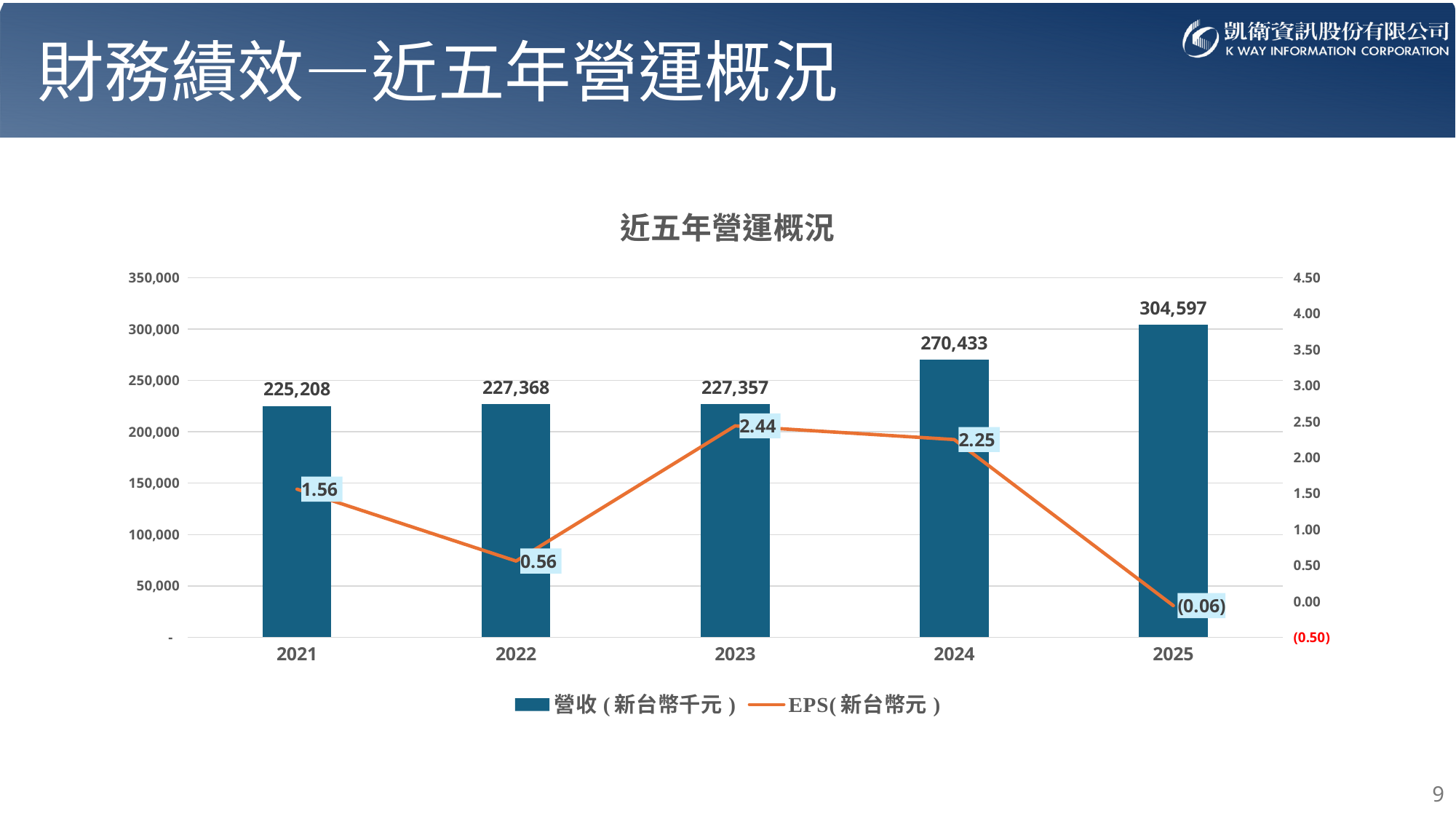
How many series does the legend list? 2 What is the EPS value for 2025? (0.06) What is the revenue (營收) value for 2025? 304,597 Which year has the larger revenue (營收), 2021 or 2024? 2024 What is the title of the chart? 近五年營運概況 How many years are shown on the x axis? 5 Is the revenue (營收) for 2025 greater or less than 300,000? greater What is the difference in revenue (營收) between 2025 and 2024? 34,164 Which year has the lowest EPS? 2025 What is the EPS value for 2023? 2.44 Which year has the highest EPS? 2023 Which year has the highest revenue (營收)? 2025